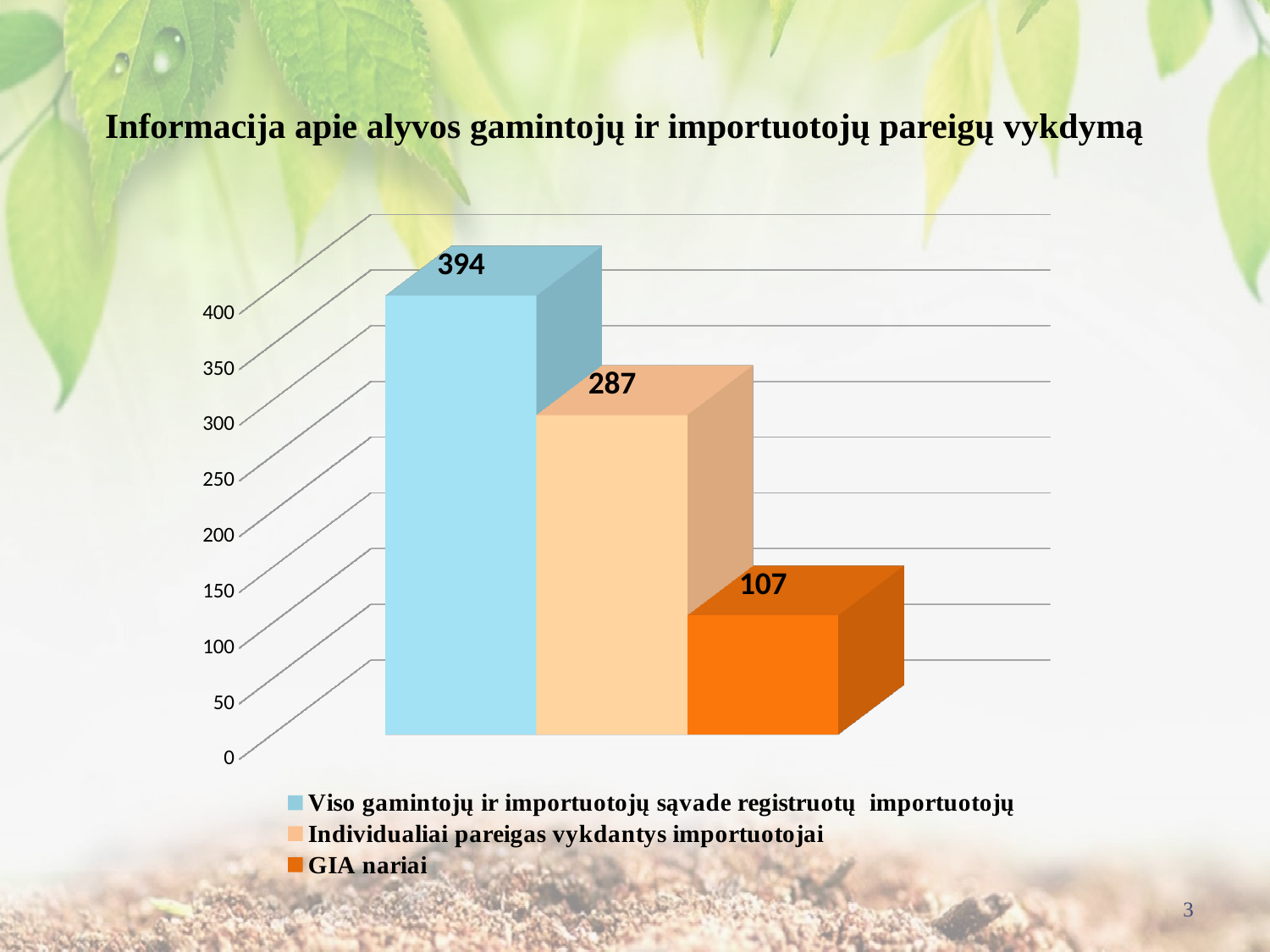
What colour is the bar for "GIA nariai"? orange What is the value for "GIA nariai"? 107 What is the difference between the value for "Individualiai pareigas vykdantys importuotojai" and the value for "GIA nariai"? 180 Is the value for "GIA nariai" greater or less than 150? less What is the value for "Individualiai pareigas vykdantys importuotojai"? 287 How many series does the legend list? 3 What is the difference between the value for "Viso gamintojų ir importuotojų sąvade registruotų importuotojų" and the value for "Individualiai pareigas vykdantys importuotojai"? 107 What is the value for "Viso gamintojų ir importuotojų sąvade registruotų importuotojų"? 394 Which series has the lowest value? GIA nariai Which series has the highest value? Viso gamintojų ir importuotojų sąvade registruotų importuotojų What kind of chart is shown on the slide? bar chart Which is larger: the value for "Individualiai pareigas vykdantys importuotojai" or the value for "GIA nariai"? Individualiai pareigas vykdantys importuotojai